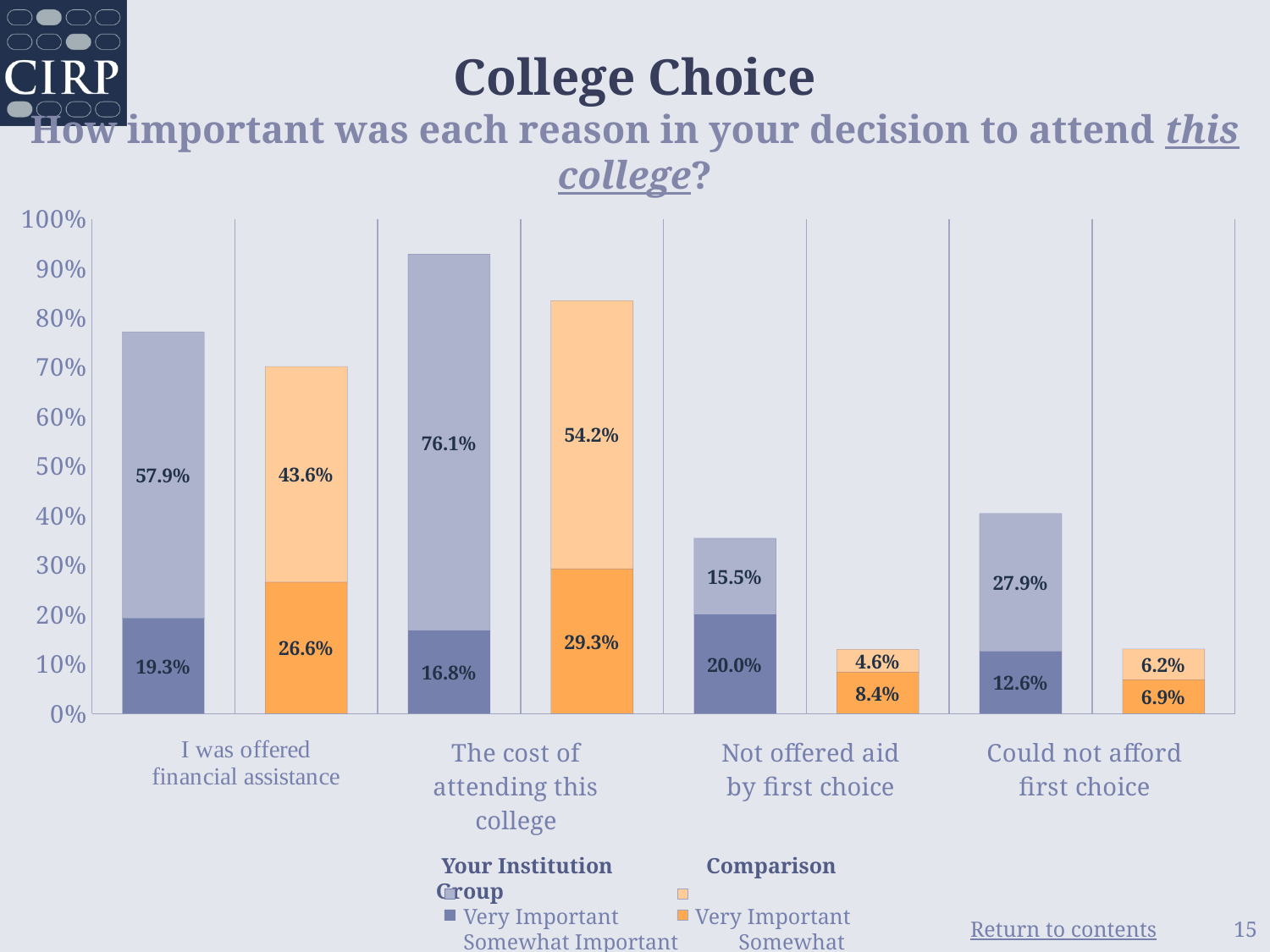
Which reason has the tallest Your Institution stacked bar? The cost of attending this college How many series does the legend list? 4 What percentage of the Comparison Group rated "I was offered financial assistance" as Very Important? 26.6% What percentage of Your Institution respondents rated "The cost of attending this college" as Somewhat Important? 76.1% For "I was offered financial assistance", which group has the larger Somewhat Important percentage, Your Institution or the Comparison Group? Your Institution Which reason has the shortest Comparison Group stacked bar? Not offered aid by first choice What is the total height of the Comparison Group stacked bar for "Not offered aid by first choice"? 13.0% What kind of chart is shown on the slide? Stacked bar chart What is the total height of the Your Institution stacked bar for "The cost of attending this college"? 92.9% What is the difference between the Your Institution and Comparison Group Very Important percentages for "Could not afford first choice"? 5.7% What percentage of Your Institution respondents rated "Not offered aid by first choice" as Very Important? 20.0% How many reasons (categories) are shown on the x axis? 4